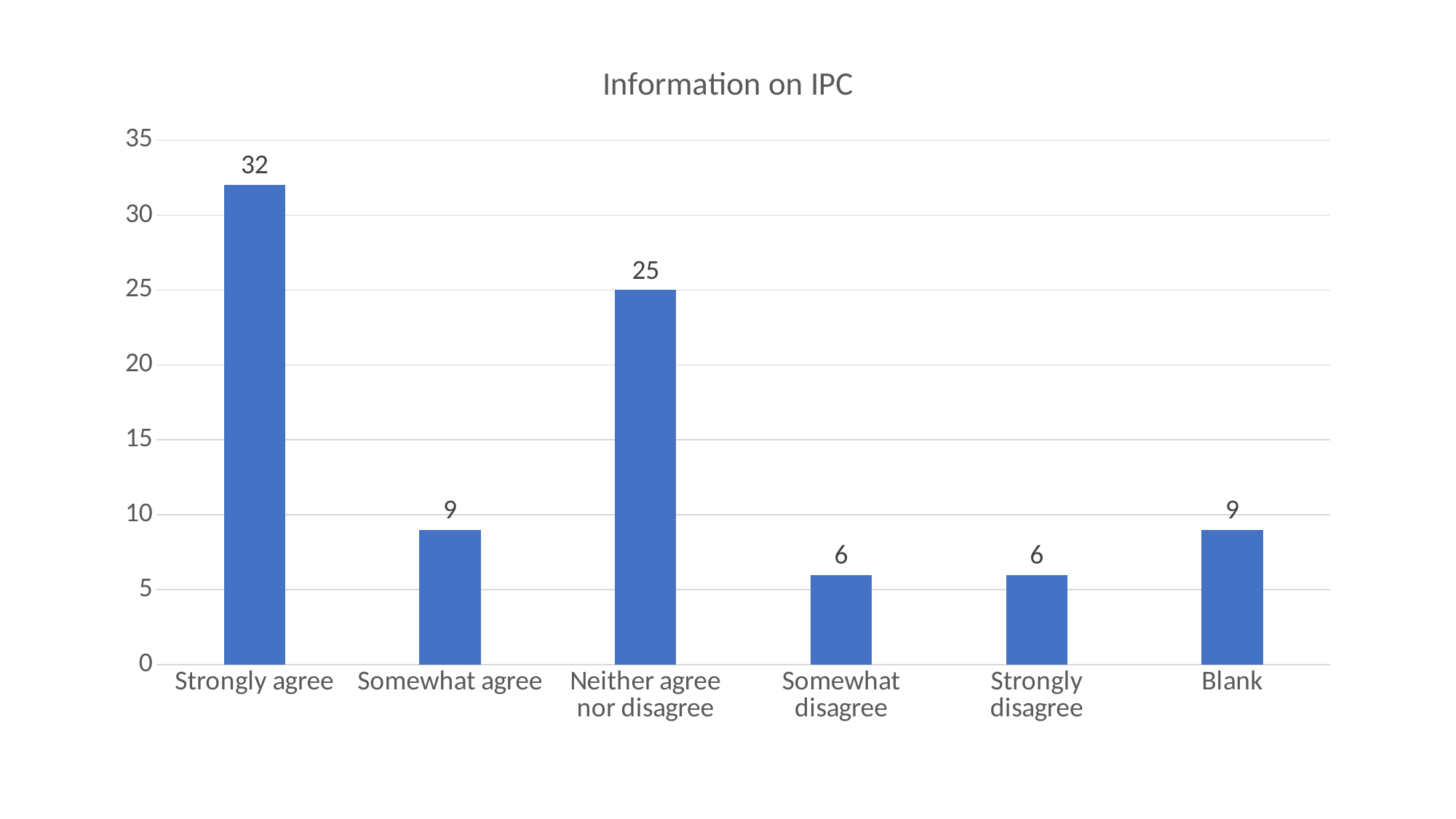
Which is larger, the value for Somewhat agree or the value for Somewhat disagree? Somewhat agree What is the title of the chart? Information on IPC What is the value for Somewhat disagree? 6 What is the value for Strongly agree? 32 What is the value for Neither agree nor disagree? 25 What is the difference between the values for Somewhat agree and Strongly disagree? 3 What is the difference between the values for Strongly agree and Neither agree nor disagree? 7 Which category has the highest value? Strongly agree Is the value for Neither agree nor disagree greater or less than 20? greater What is the value for Blank? 9 What kind of chart is shown on the slide? Bar chart How many categories are shown on the x axis? 6